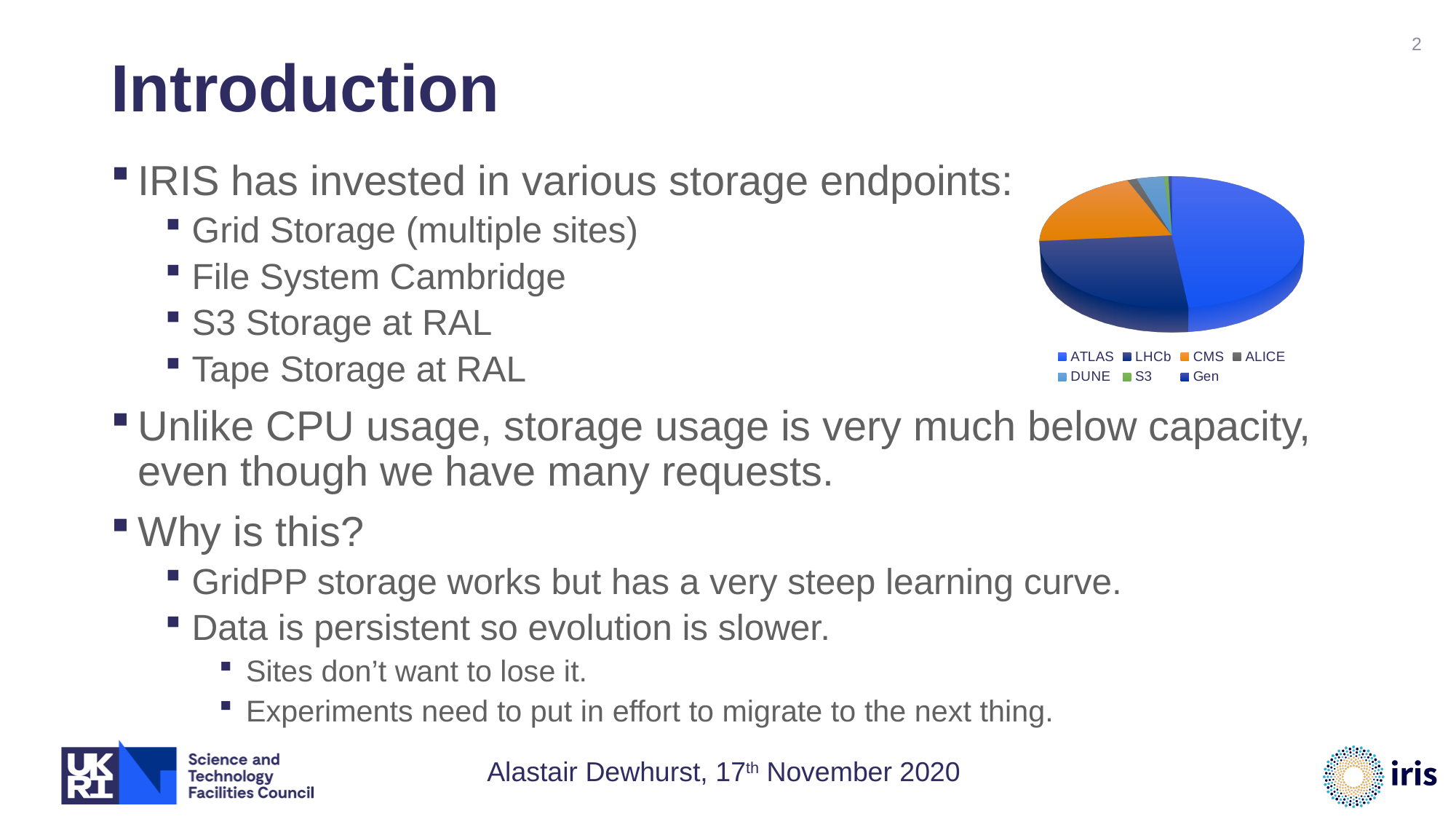
What kind of chart is shown on the slide? pie chart Which slice is larger in the pie chart, LHCb or DUNE? LHCb Which slice is larger in the pie chart, CMS or S3? CMS Which category has the largest slice in the pie chart? ATLAS Which slice is larger in the pie chart, LHCb or CMS? LHCb Which category is shown in green in the pie chart's legend? S3 How many categories does the pie chart's legend list? 7 Which category is shown in orange in the pie chart? CMS